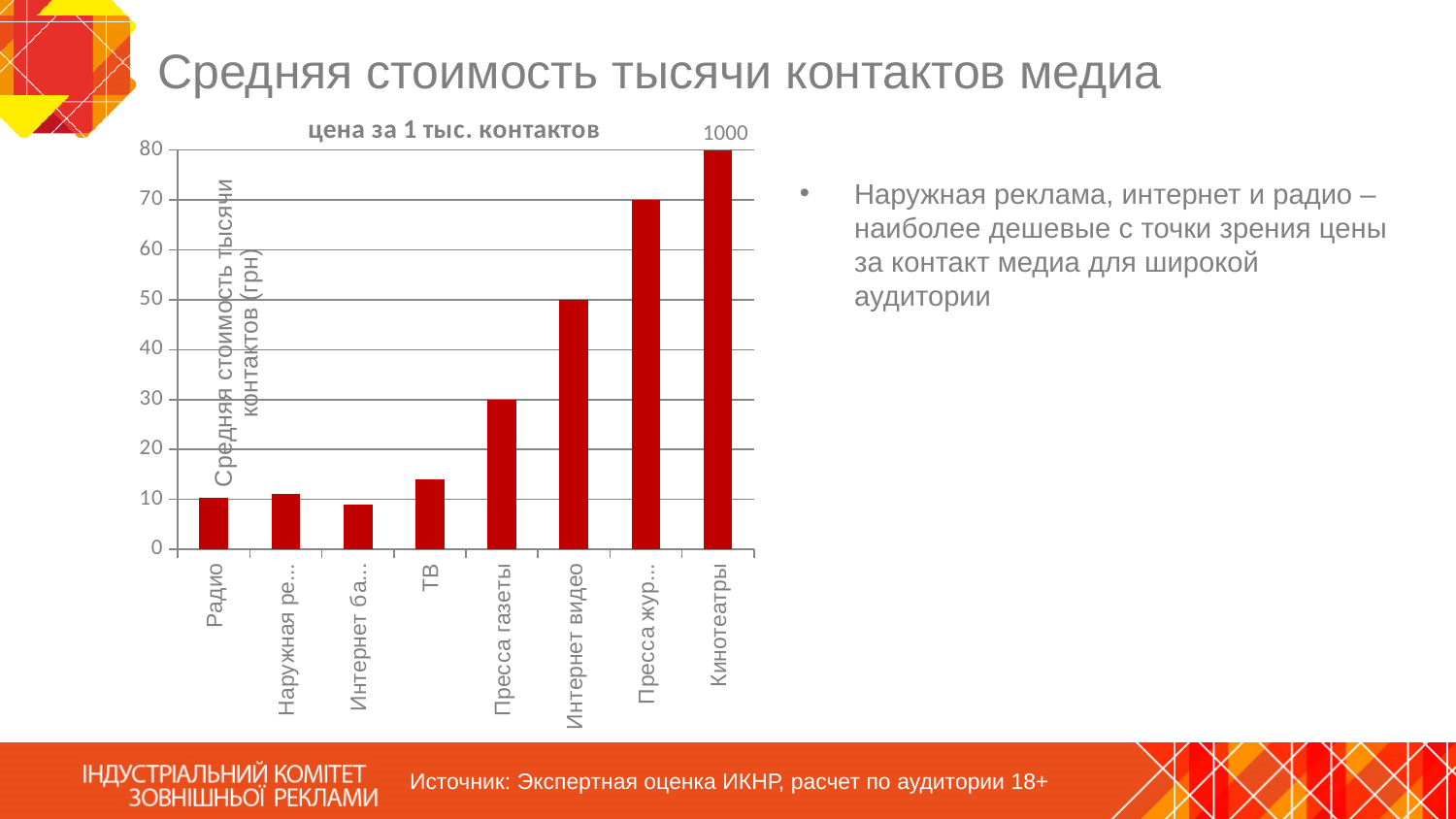
Do the values generally rise or fall from left to right along the x axis? rise Which is larger, the value for Пресса газеты or the value for ТВ? Пресса газеты Is the value for ТВ greater or less than 20? less What is the value for Интернет видео? 50 What is the title of the chart? цена за 1 тыс. контактов Is the value for Радио greater or less than 20? less What is the value labelled for Кинотеатры? 1000 What kind of chart is shown on the slide? bar chart How many categories are shown on the x axis of the chart? 8 What is the difference between the values for Интернет видео and Пресса газеты? 20 What is the value for Пресса газеты? 30 Which category has the highest value in the chart? Кинотеатры